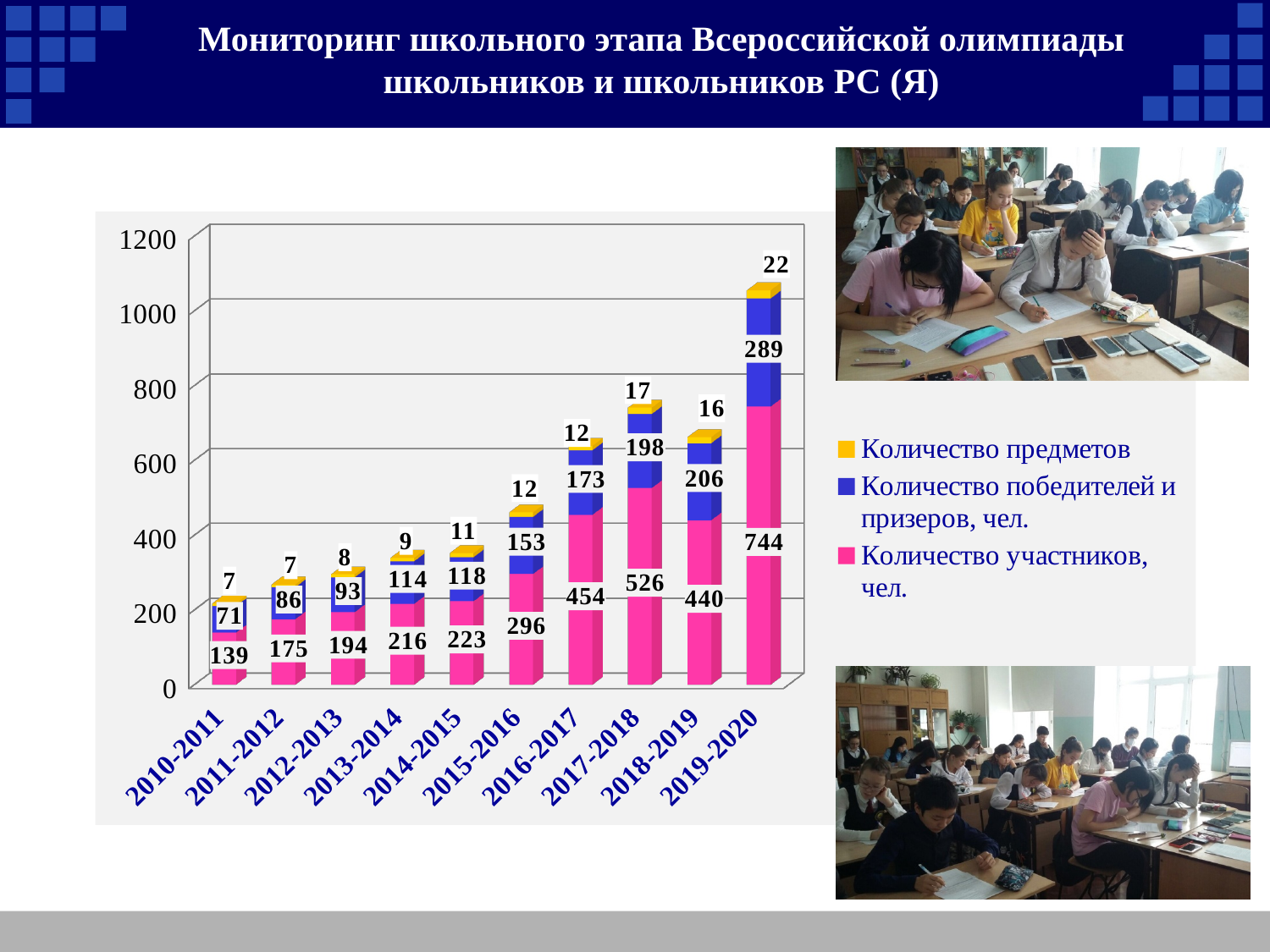
What is the difference between Количество участников, чел. in 2017-2018 and in 2018-2019? 86 What type of chart is shown on the slide? stacked bar chart Which school year has the lowest value for Количество победителей и призеров, чел.? 2010-2011 What is the value of Количество участников, чел. for 2019-2020? 744 Which is larger: Количество победителей и призеров, чел. in 2018-2019 or in 2017-2018? 2018-2019 Which school year has the highest value for Количество участников, чел.? 2019-2020 How many series does the legend list? 3 What is the value of Количество победителей и призеров, чел. for 2017-2018? 198 What is the value of Количество предметов for 2014-2015? 11 Which colour represents Количество предметов in the legend? yellow What is the total of the stacked bar for 2019-2020? 1055 How many school-year categories are shown on the x axis? 10